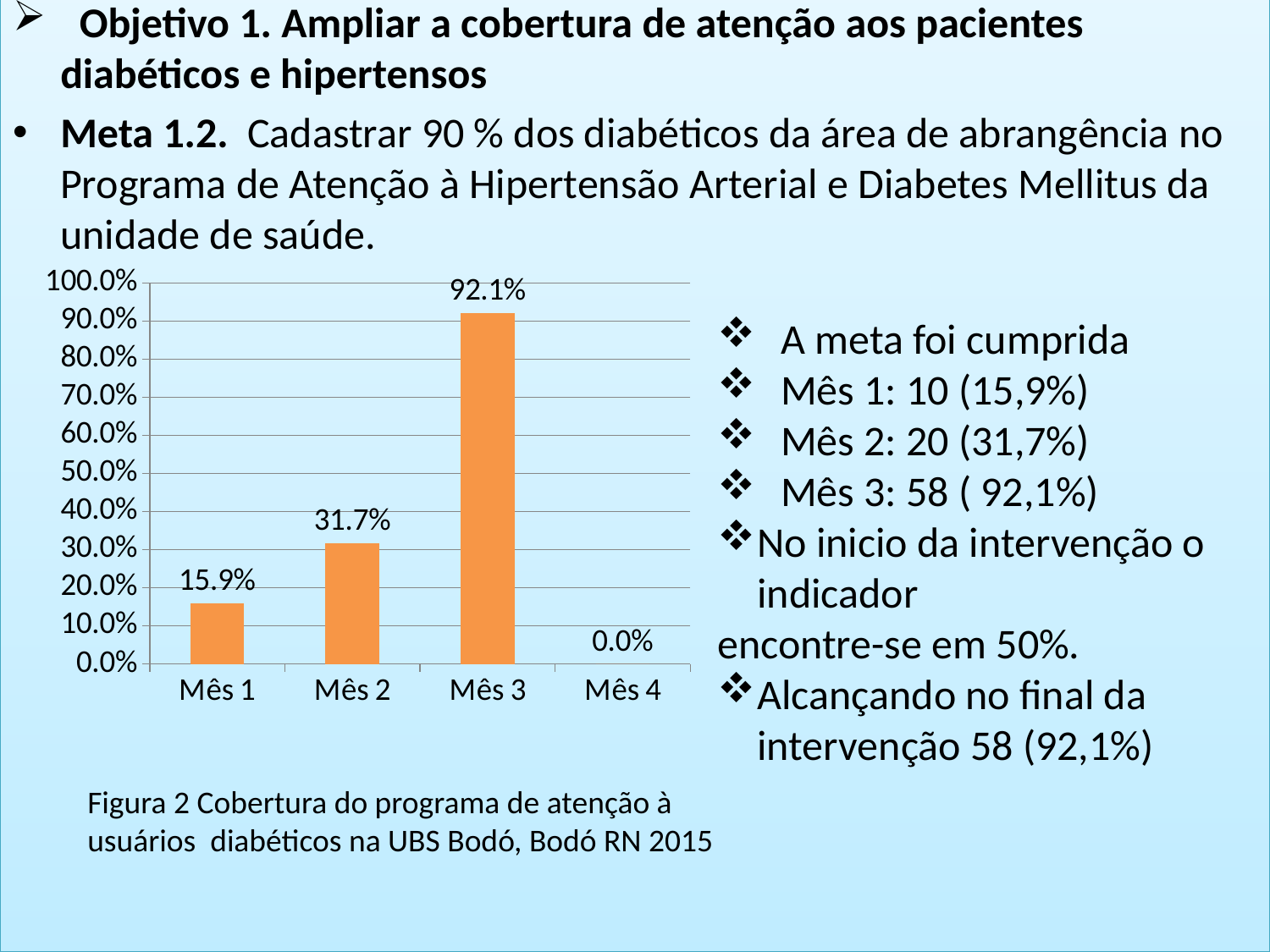
How many months are shown on the x axis? 4 What is the difference between the values for Mês 2 and Mês 1? 15.8% Which is larger, the value for Mês 1 or the value for Mês 2? Mês 2 What is the difference between the values for Mês 3 and Mês 2? 60.4% Which month has the lowest value? Mês 4 What is the value for Mês 3? 92.1% What is the value for Mês 4? 0.0% What is the value for Mês 1? 15.9% Which month has the highest value? Mês 3 What is the value for Mês 2? 31.7% What is the caption of the figure below the chart? Figura 2 Cobertura do programa de atenção à usuários diabéticos na UBS Bodó, Bodó RN 2015 What kind of chart is shown on the slide? Bar chart